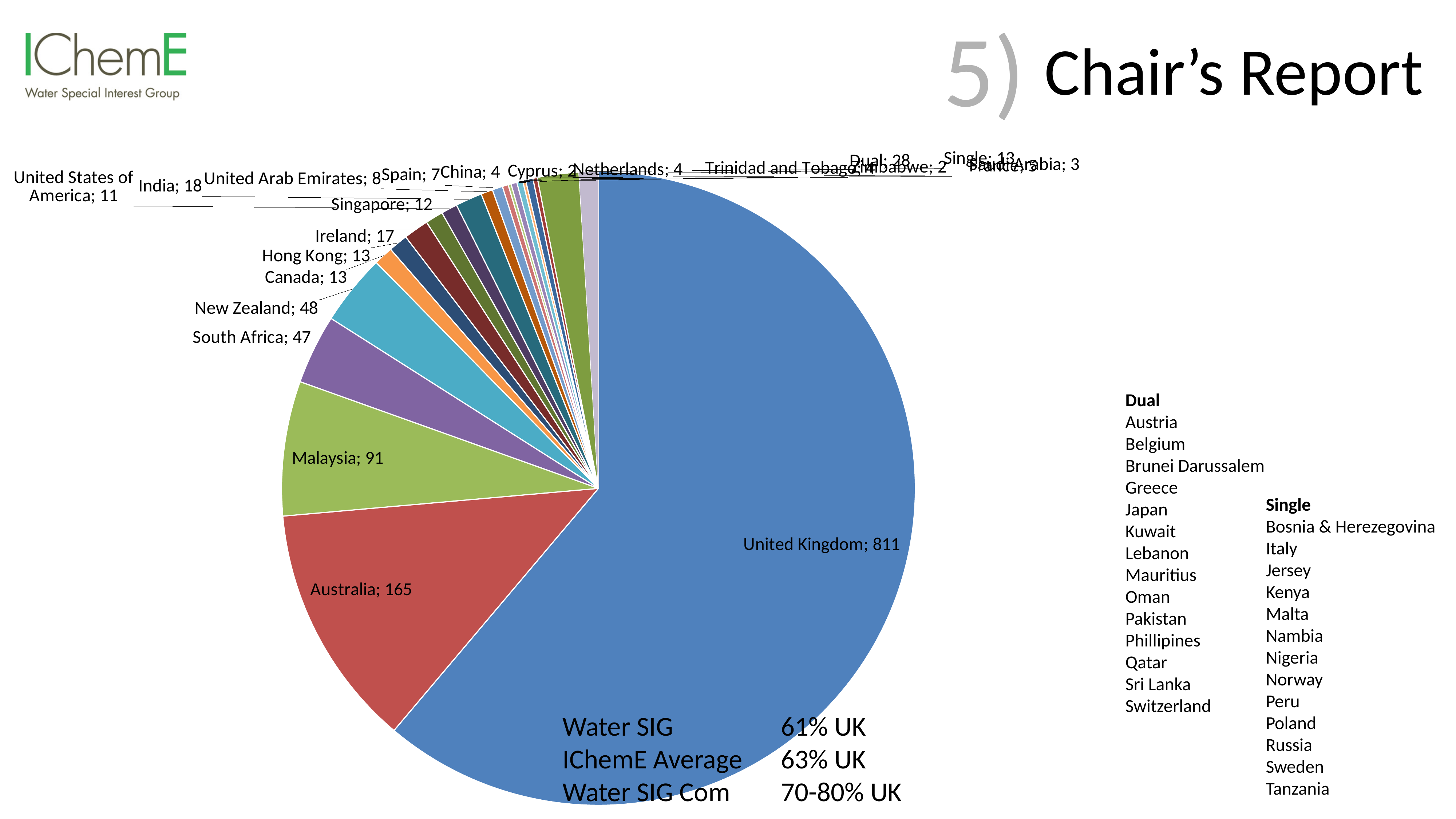
What is the value for Dual in the pie chart? 28 What is the value for United Kingdom in the pie chart? 811 Which category has the largest slice in the pie chart? United Kingdom What is the difference between the values for United Kingdom and Australia? 646 What is the value for Australia in the pie chart? 165 What kind of chart is shown on the slide? Pie chart Which is larger, the value for Australia or the value for Malaysia? Australia What is the value for Singapore in the pie chart? 12 What is the difference between the values for Australia and Malaysia? 74 What is the value for India in the pie chart? 18 What is the value for Ireland in the pie chart? 17 What is the value for Malaysia in the pie chart? 91